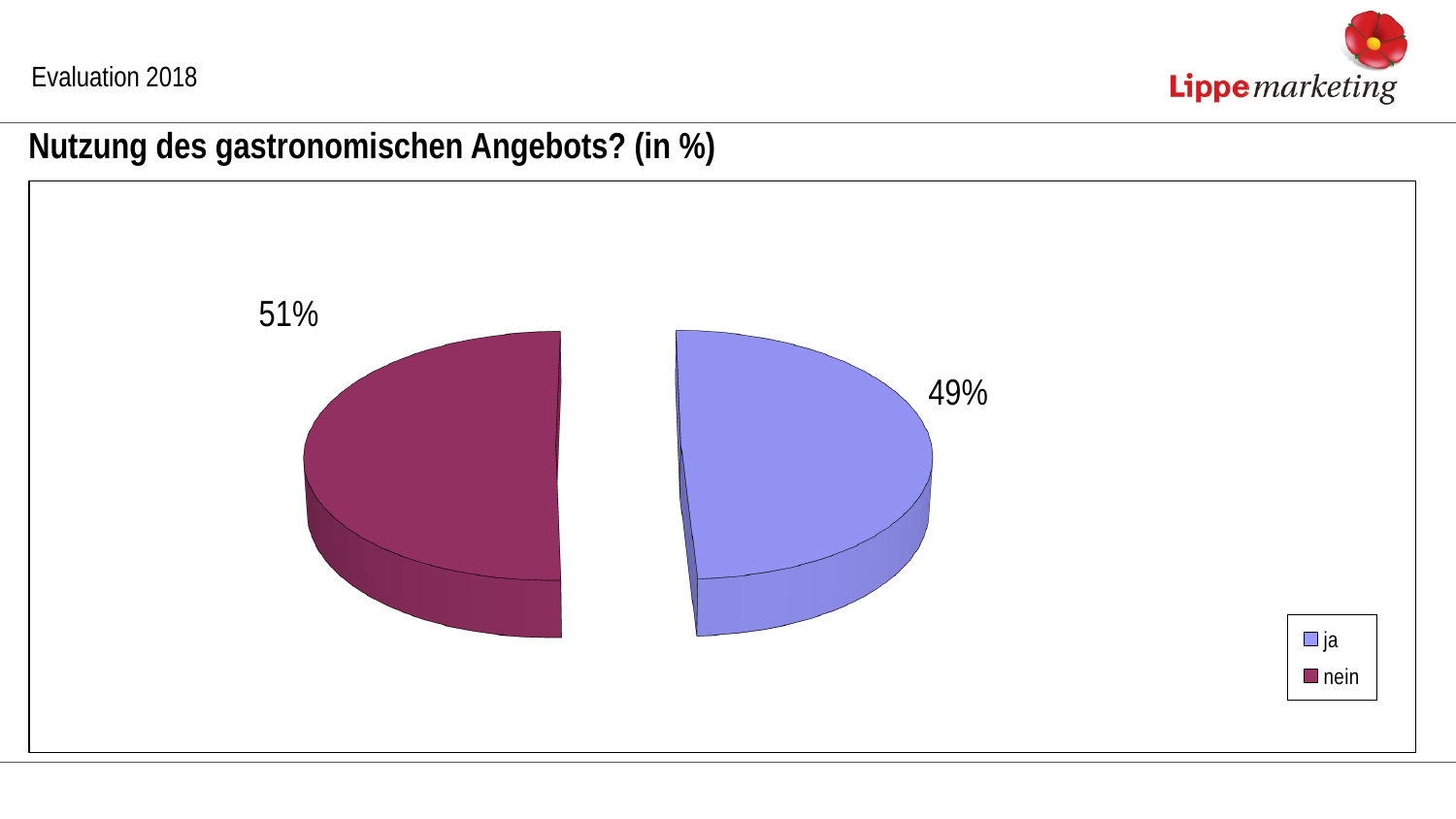
What colour is the "nein" slice? dark red / magenta How many slices does the pie chart have? 2 Which category has the smallest share of the pie? ja What percentage is shown for "ja"? 49% What kind of chart is shown on the slide? pie chart How many entries does the legend list? 2 Which category has the largest share of the pie? nein Which slice is larger, "ja" or "nein"? nein What percentage is shown for "nein"? 51% What is the title of the chart? Nutzung des gastronomischen Angebots? (in %) What is the difference in percentage points between "nein" and "ja"? 2 Is the share for "ja" greater or less than 50%? less